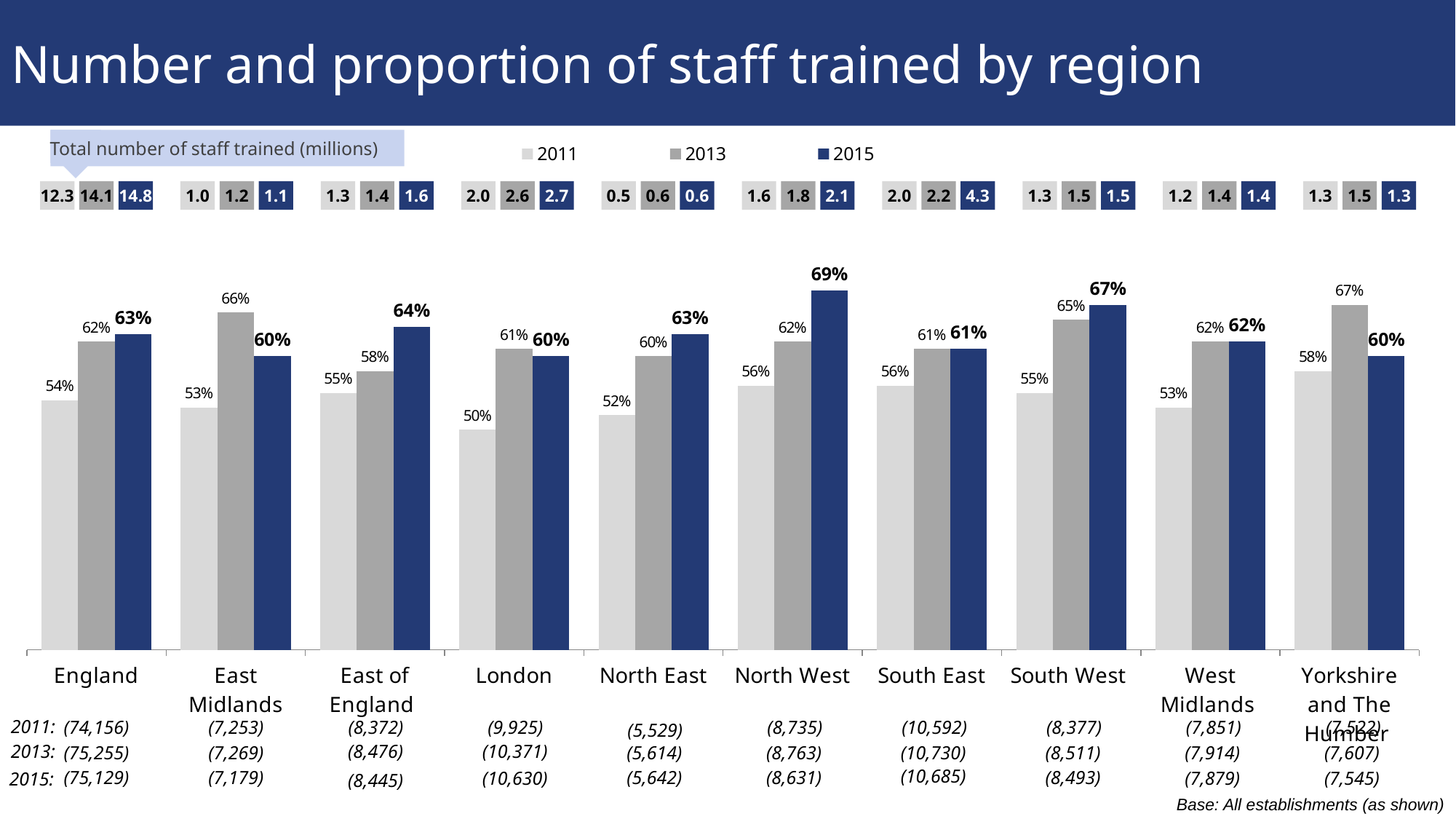
What proportion of staff were trained in East Midlands in 2013? 66% How many series does the legend list? 3 What kind of chart is shown on the slide? Bar chart Which region has the highest proportion of staff trained in 2015? North West What proportion of staff were trained in London in 2011? 50% For England, does the proportion of staff trained rise or fall from 2011 to 2015? Rise Which region has the lowest proportion of staff trained in 2011? London How many regions are shown on the x axis of the chart? 10 What proportion of staff were trained in North West in 2015? 69% For East Midlands, which year has the larger proportion of staff trained, 2013 or 2015? 2013 What is the difference in percentage points between the 2015 and 2011 proportions for North West? 13 percentage points What is the total number of staff trained (millions) shown for England in 2015? 14.8